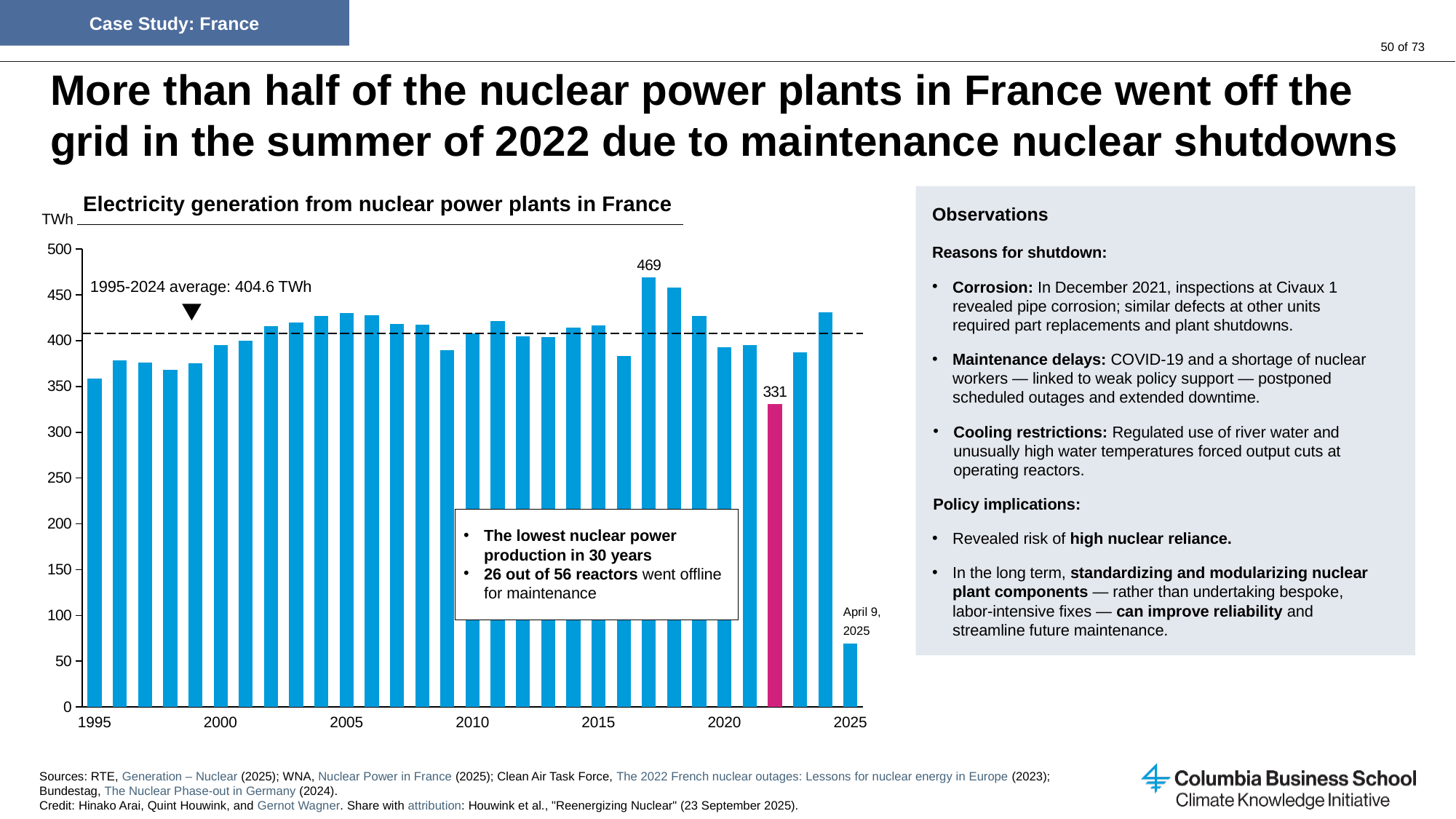
Is the value for 1995 greater or less than 400? less Which is larger, the value for 2017 or the value for 2022? 2017 What was France's nuclear electricity generation in 2022, according to the data label? 331 What is the difference between the labelled 2017 value and the labelled 2022 value? 138 What was France's nuclear electricity generation in 2017, according to the data label? 469 Is the value for 2016 greater or less than 400? less Which year has the highest bar in the chart? 2017 Which year has the lowest bar in the chart? 2025 What kind of chart is shown on the slide? Bar chart Which year's bar is highlighted in a different colour (pink) from the others? 2022 What is the 1995-2024 average shown by the dashed line? 404.6 TWh How many bars (years) are plotted in the chart? 31